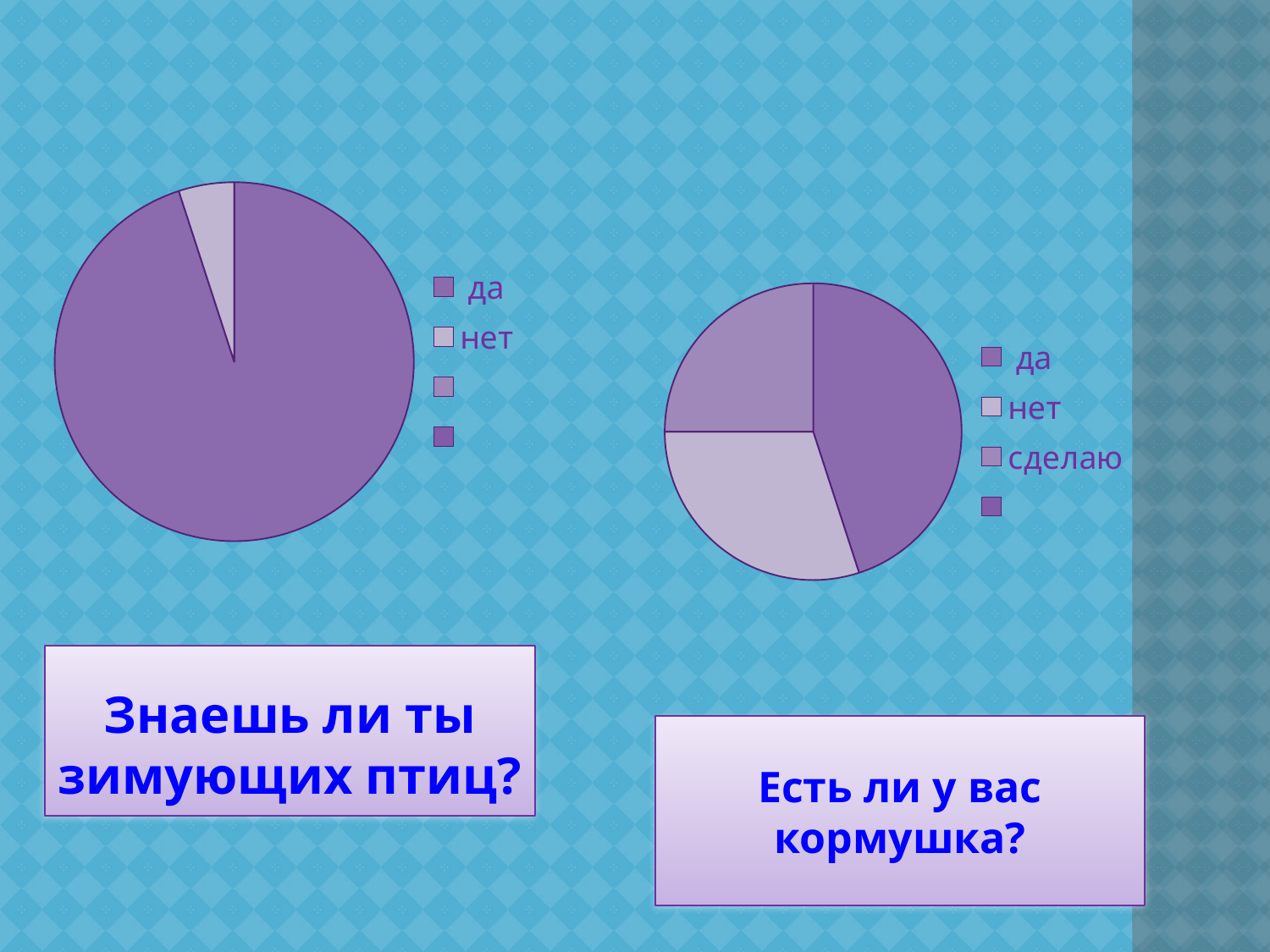
What are the labelled legend entries of the chart "Знаешь ли ты зимующих птиц?"? да, нет What type of chart is used for "Есть ли у вас кормушка?"? pie chart In the chart "Есть ли у вас кормушка?", which is larger: нет or сделаю? нет In the chart "Знаешь ли ты зимующих птиц?", which answer has the smallest slice? нет In the chart "Есть ли у вас кормушка?", which answer has the largest slice? да In the chart "Знаешь ли ты зимующих птиц?", which is larger: да or нет? да In the chart "Знаешь ли ты зимующих птиц?", which answer has the largest slice? да What type of chart is used for "Знаешь ли ты зимующих птиц?"? pie chart In the chart "Есть ли у вас кормушка?", which answer has the smallest slice? сделаю How many slices does the pie chart "Знаешь ли ты зимующих птиц?" have? 2 How many slices does the pie chart "Есть ли у вас кормушка?" have? 3 What are the labelled legend entries of the chart "Есть ли у вас кормушка?"? да, нет, сделаю